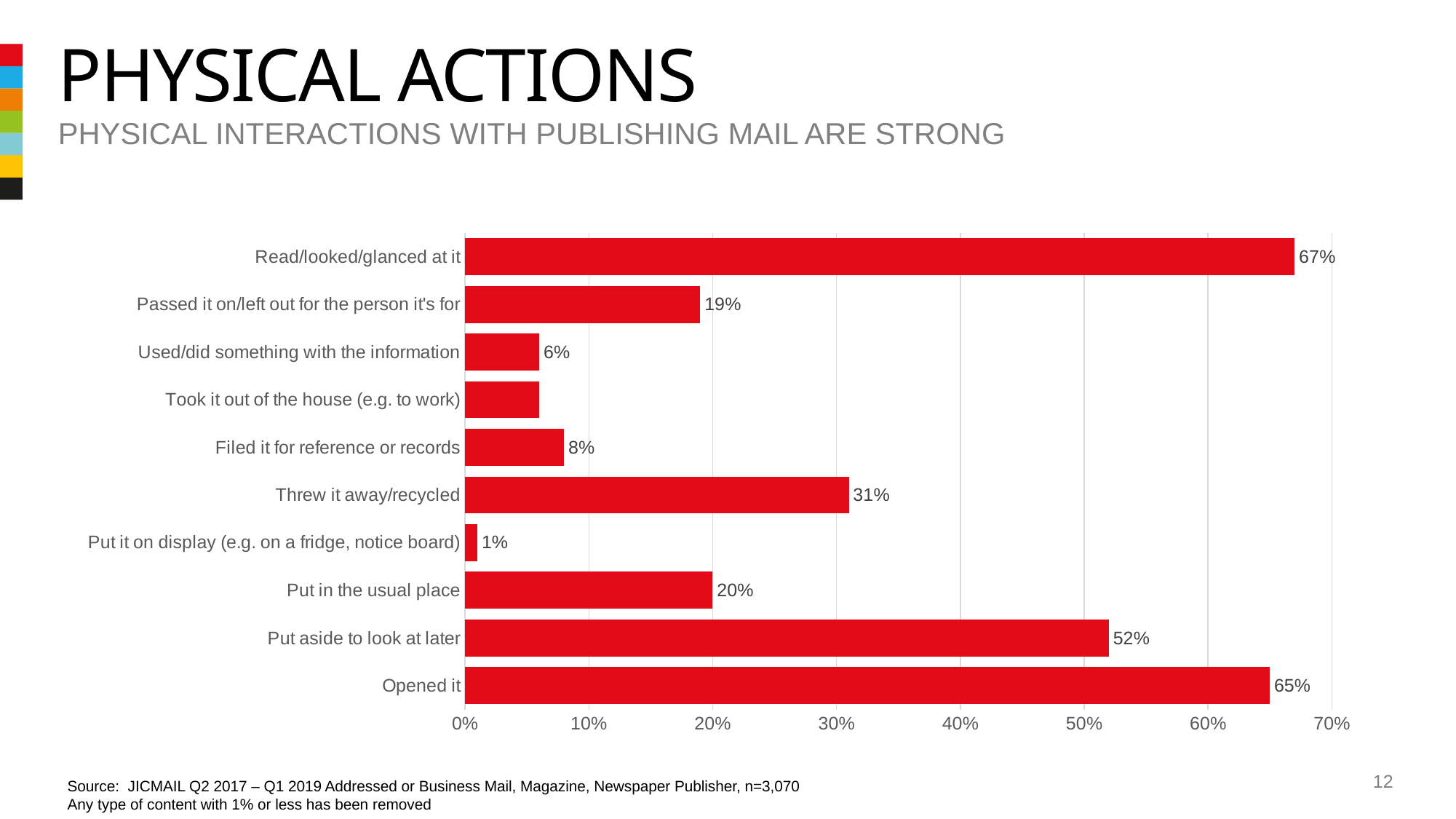
What is the difference between "Opened it" and "Put aside to look at later"? 13% Which is larger, "Put in the usual place" or "Passed it on/left out for the person it's for"? Put in the usual place What is the value for "Read/looked/glanced at it"? 67% How many categories are shown in the chart? 10 Is the value for "Took it out of the house (e.g. to work)" greater or less than 10%? less What colour are the bars in the chart? Red What is the value for "Threw it away/recycled"? 31% Which category has the highest value? Read/looked/glanced at it What is the value for "Filed it for reference or records"? 8% What kind of chart is shown on the slide? Bar chart What is the value for "Put aside to look at later"? 52% Which category has the lowest value? Put it on display (e.g. on a fridge, notice board)